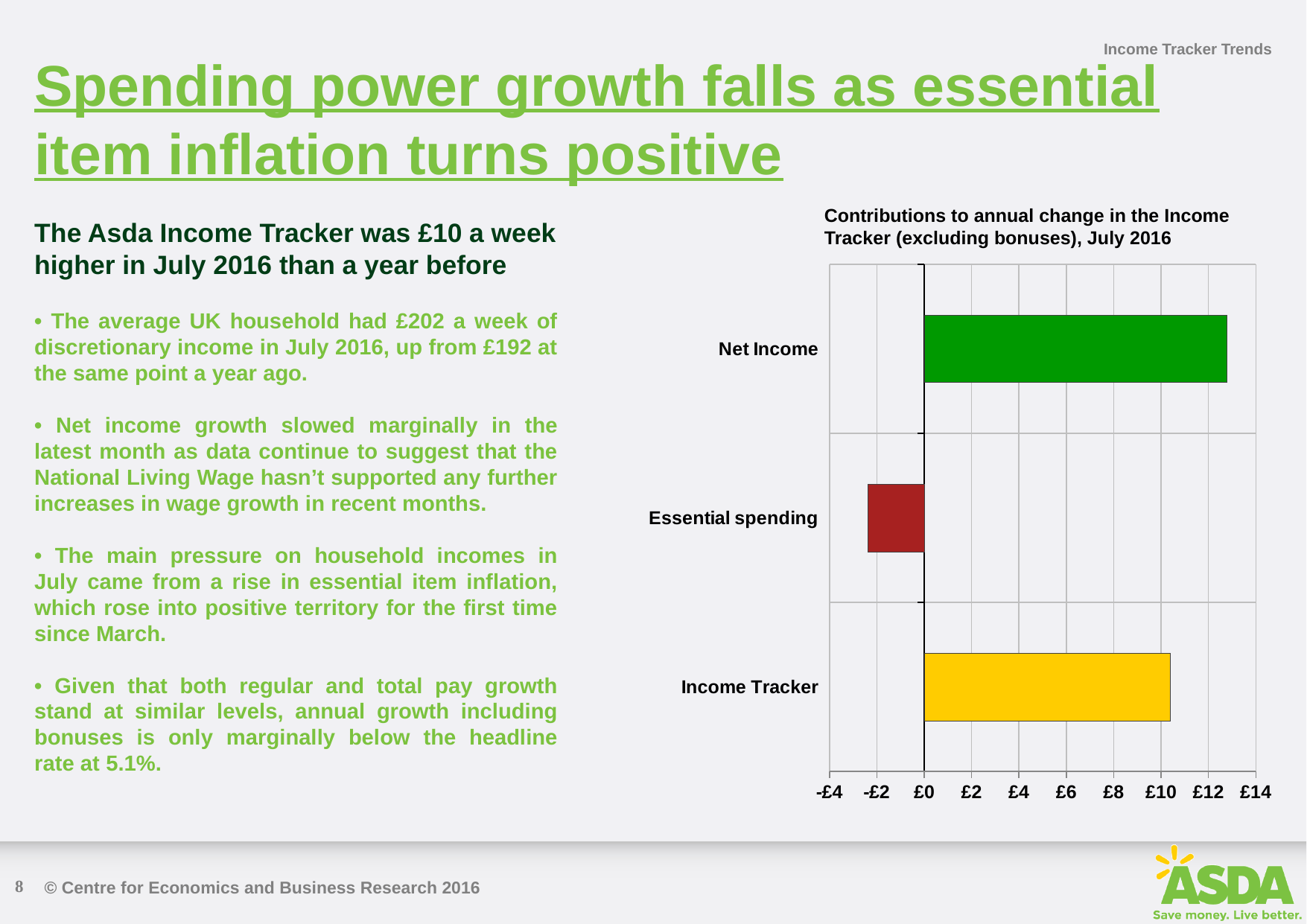
Is the value for Income Tracker greater or less than £10? greater Which category in the chart has a negative value? Essential spending What is the title of the chart? Contributions to annual change in the Income Tracker (excluding bonuses), July 2016 Is the value for Net Income greater or less than £12? greater Which category has the lowest value in the chart? Essential spending Is the value for Income Tracker greater or less than £12? less How many categories are plotted in the chart? 3 Which category has the highest value in the chart? Net Income What kind of chart is shown on the slide? bar chart Which is larger, the value for Net Income or the value for Income Tracker? Net Income